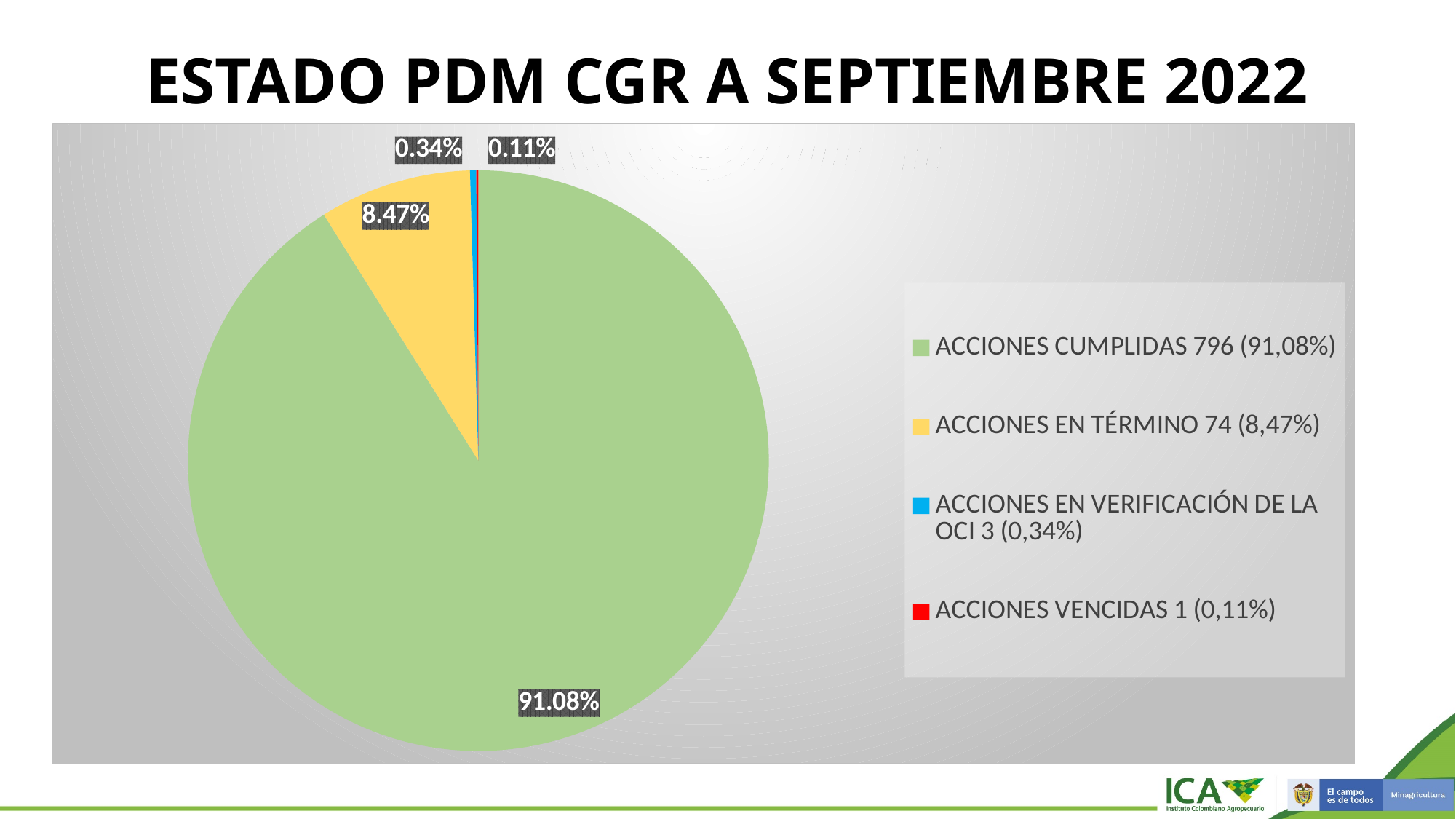
How many slices does the pie chart have? 4 What is the title of the chart on the slide? ESTADO PDM CGR A SEPTIEMBRE 2022 Which category has the smallest slice of the pie? ACCIONES VENCIDAS According to the legend, how many ACCIONES EN TÉRMINO are there? 74 What percentage of the pie is labelled for ACCIONES EN TÉRMINO? 8.47% What percentage of the pie is labelled for ACCIONES CUMPLIDAS? 91.08% What percentage of the pie is labelled for ACCIONES VENCIDAS? 0.11% Which category has the largest slice of the pie? ACCIONES CUMPLIDAS According to the legend, how many ACCIONES CUMPLIDAS are there? 796 What kind of chart is shown on the slide? pie chart What is the difference in percentage points between the ACCIONES CUMPLIDAS slice and the ACCIONES EN TÉRMINO slice? 82.61%